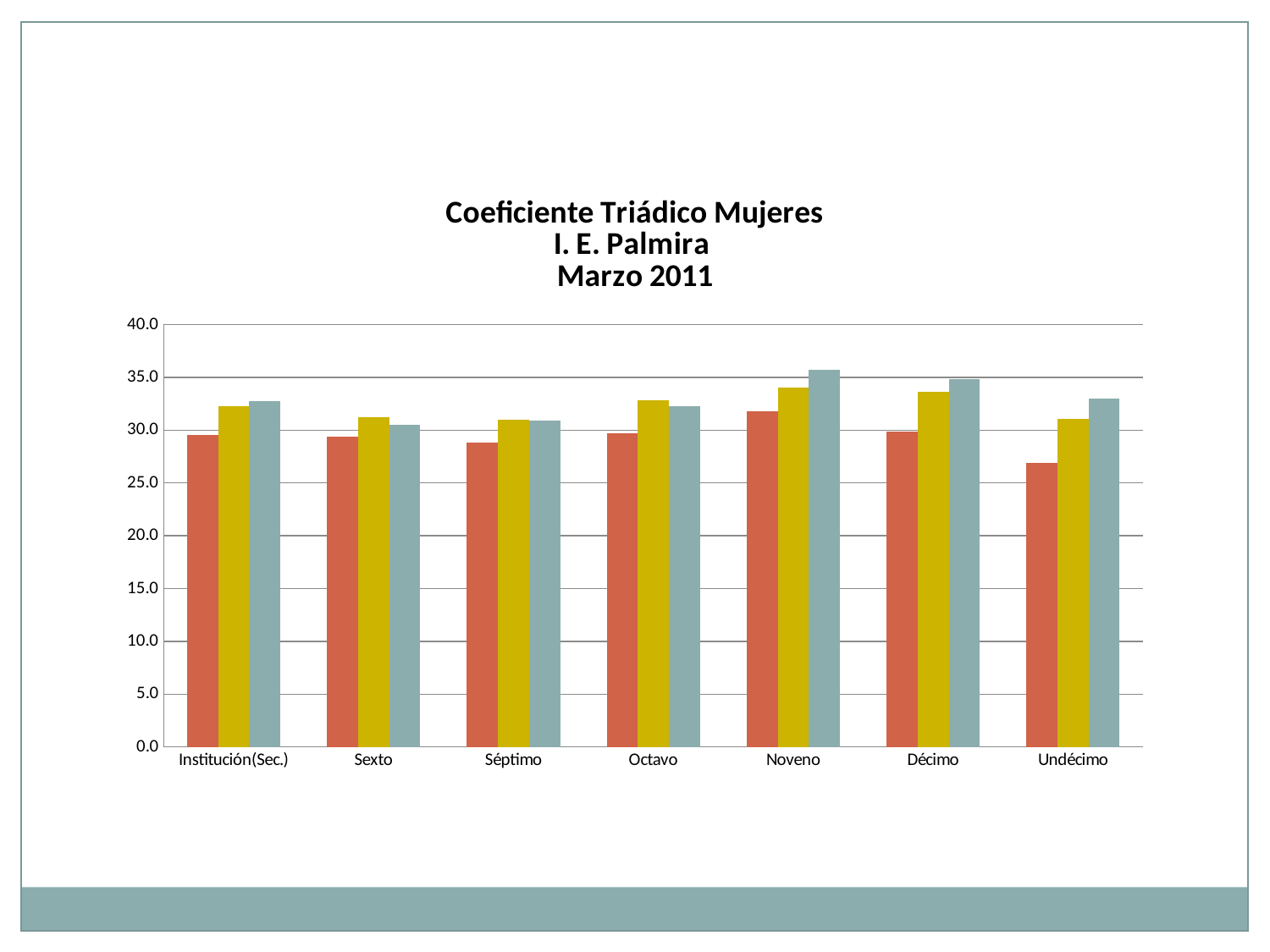
Is the value of the red bar for Noveno greater or less than 30.0? greater What kind of chart is shown on the slide? bar chart Among the red bars, which category has the lowest value? Undécimo Is the value of the red bar for Undécimo greater or less than 30.0? less Is the value of the teal bar for Noveno greater or less than 35.0? greater How many bars are plotted for each category in the chart? 3 For Undécimo, which is larger: the red bar or the teal bar? the teal bar What is the title of the chart? Coeficiente Triádico Mujeres I. E. Palmira Marzo 2011 How many categories are shown along the x axis of the chart? 7 Among the red bars, which category has the highest value? Noveno Which is larger: the teal bar for Noveno or the teal bar for Sexto? the teal bar for Noveno